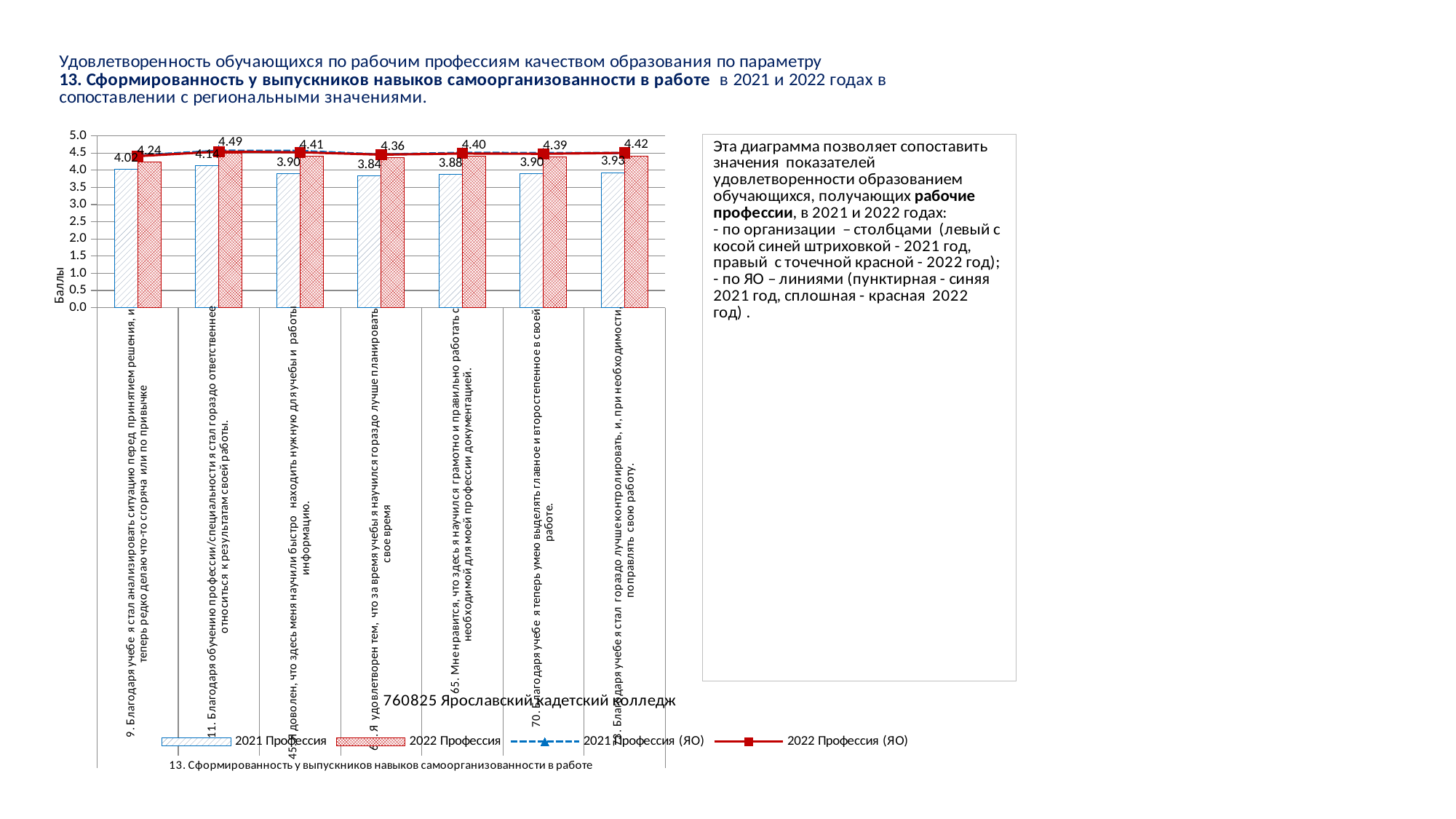
What is the difference between the 2022 Профессия and 2021 Профессия values for category 65? 0.52 What is the difference between the 2022 Профессия and 2021 Профессия values for category 11? 0.35 Which is larger: the 2021 Профессия value for category 9 or for category 11? Category 11 (4.14) What is the title of the vertical axis of the chart? Баллы Which category has the highest 2021 Профессия value? 11. Благодаря обучению профессии/специальности я стал гораздо ответственнее относиться к результатам своей работы (4.14) What is the value of the 2022 Профессия bar for category 65 (Мне нравится, что здесь я научился грамотно и правильно работать с необходимой для моей профессии документацией)? 4.40 How many series does the chart legend list? 4 Is the 2022 Профессия value for category 9 greater or less than 4.0? greater What is the value of the 2021 Профессия bar for category 70 (Благодаря учебе я теперь умею выделять главное и второстепенное в своей работе)? 3.90 How many categories are shown on the x axis of the chart? 7 Which category has the highest 2022 Профессия value? 11. Благодаря обучению профессии/специальности я стал гораздо ответственнее относиться к результатам своей работы (4.49) Which category has the lowest 2021 Профессия value? Я удовлетворен тем, что за время учебы я научился гораздо лучше планировать свое время (3.84)